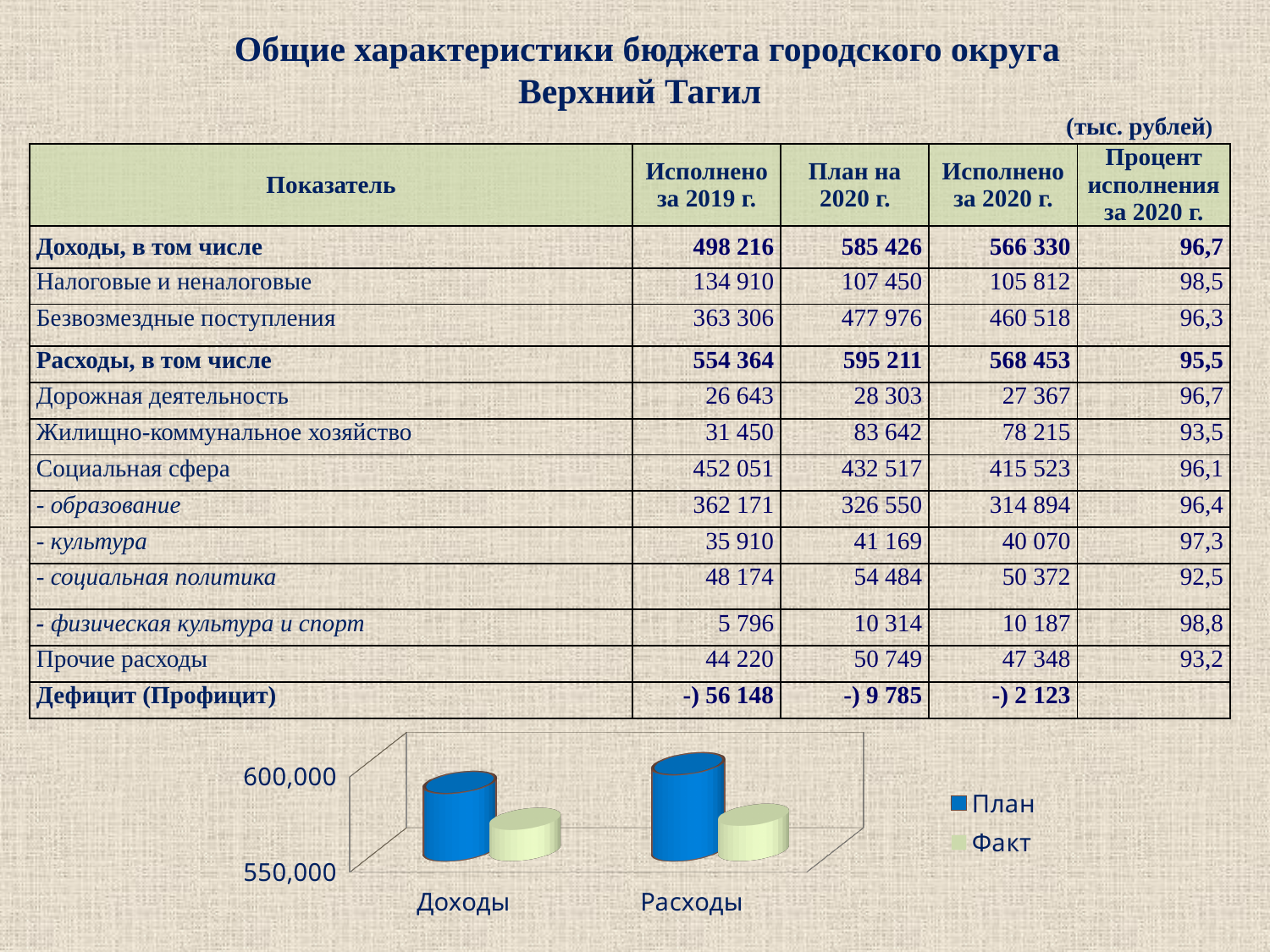
In the chart, which is larger for Расходы: План or Факт? План What kind of chart is shown at the bottom of the slide? bar chart How many series does the chart legend list? 2 What colour represents the План series in the chart? blue In the chart, which category has the higher План value: Доходы or Расходы? Расходы Which bar is the tallest in the chart? План for Расходы Which series are listed in the chart legend? План, Факт Is the Факт value for Расходы in the chart greater or less than 600,000? less Is the Факт value for Доходы in the chart greater or less than 600,000? less How many categories are shown on the x axis of the chart? 2 Is the План value for Расходы in the chart greater or less than 550,000? greater In the chart, which is larger for Доходы: План or Факт? План